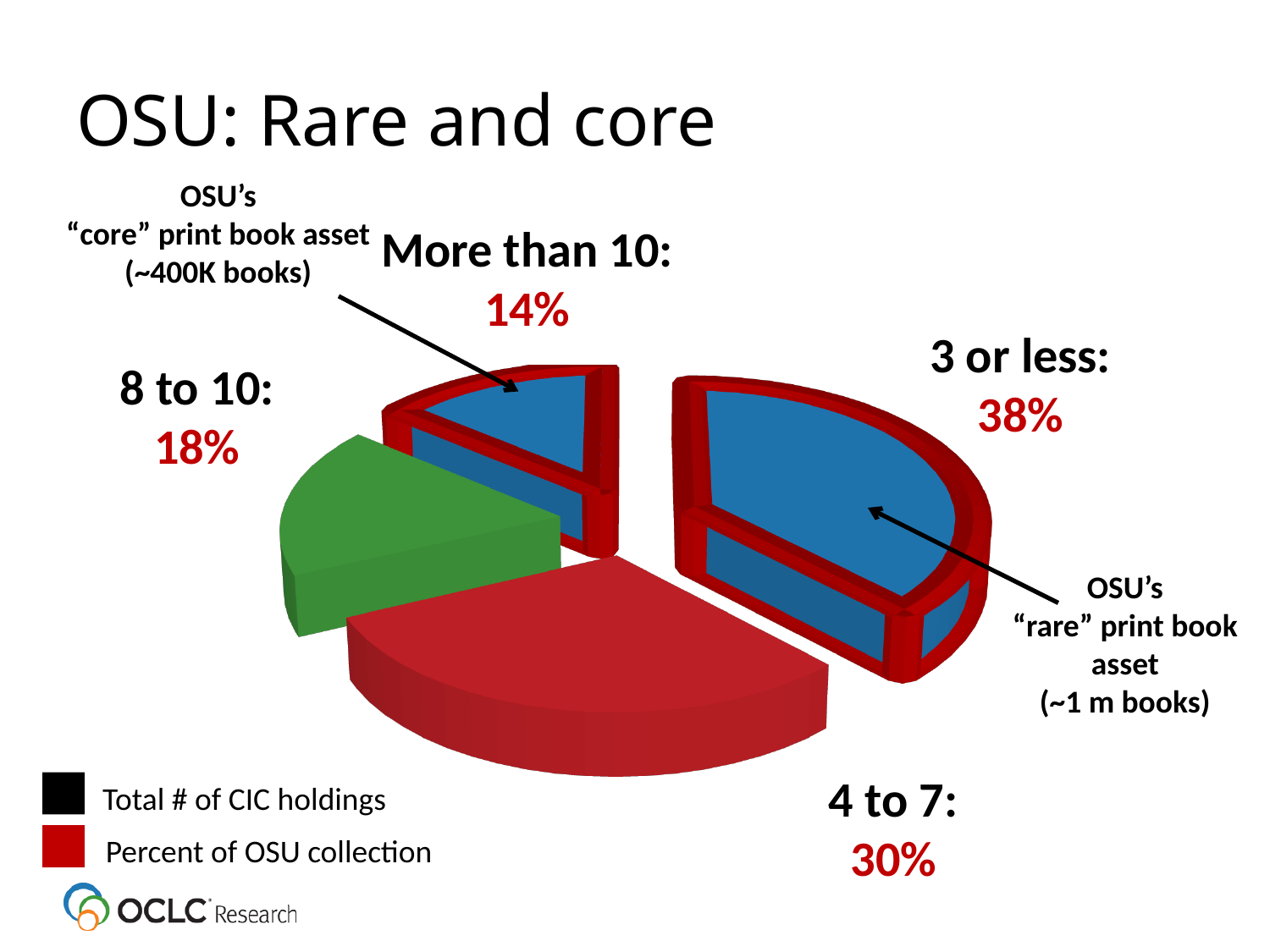
How many categories (slices) does the pie chart have? 4 Which category has the smallest share of the pie? More than 10 What is the title of the slide containing the pie chart? OSU: Rare and core What percentage of the OSU collection is in the "4 to 7" category? 30% What is the difference in percentage points between the "3 or less" and "More than 10" categories? 24 What percentage of the OSU collection is in the "3 or less" category? 38% Which slice is labelled as OSU's "rare" print book asset (~1 m books)? 3 or less What percentage of the OSU collection is in the "More than 10" category? 14% What type of chart is shown on the slide? pie chart What percentage of the OSU collection is in the "8 to 10" category? 18% Which category has the largest share of the pie? 3 or less Which is larger, the share for "4 to 7" or the share for "8 to 10"? 4 to 7